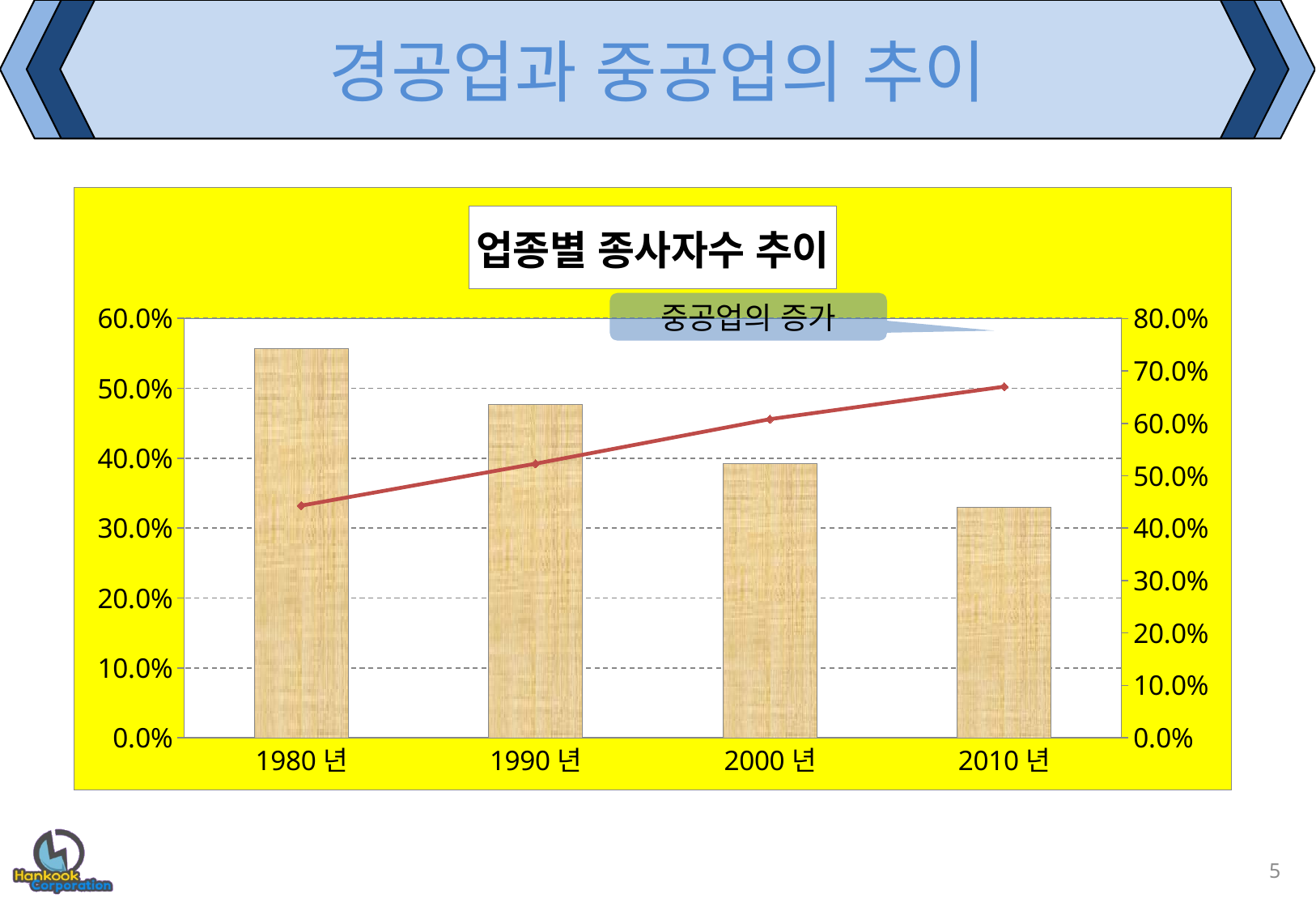
What kind of chart is shown on the slide? Combined bar and line chart What text is written in the callout box above the line series? 중공업의 증가 Is the bar value for 2010 년 greater or less than 40.0%? less Does the line series rise or fall from 1980 년 to 2010 년? Rise Which has the taller bar, 1990 년 or 2000 년? 1990 년 Which category has the tallest bar? 1980 년 Do the bar values rise or fall from 1980 년 to 2010 년? Fall What is the title of the chart? 업종별 종사자수 추이 How many categories are shown on the x axis of the chart? 4 Is the bar value for 1980 년 greater or less than 50.0%? greater Which category has the shortest bar? 2010 년 Is the bar value for 2000 년 greater or less than 30.0%? greater